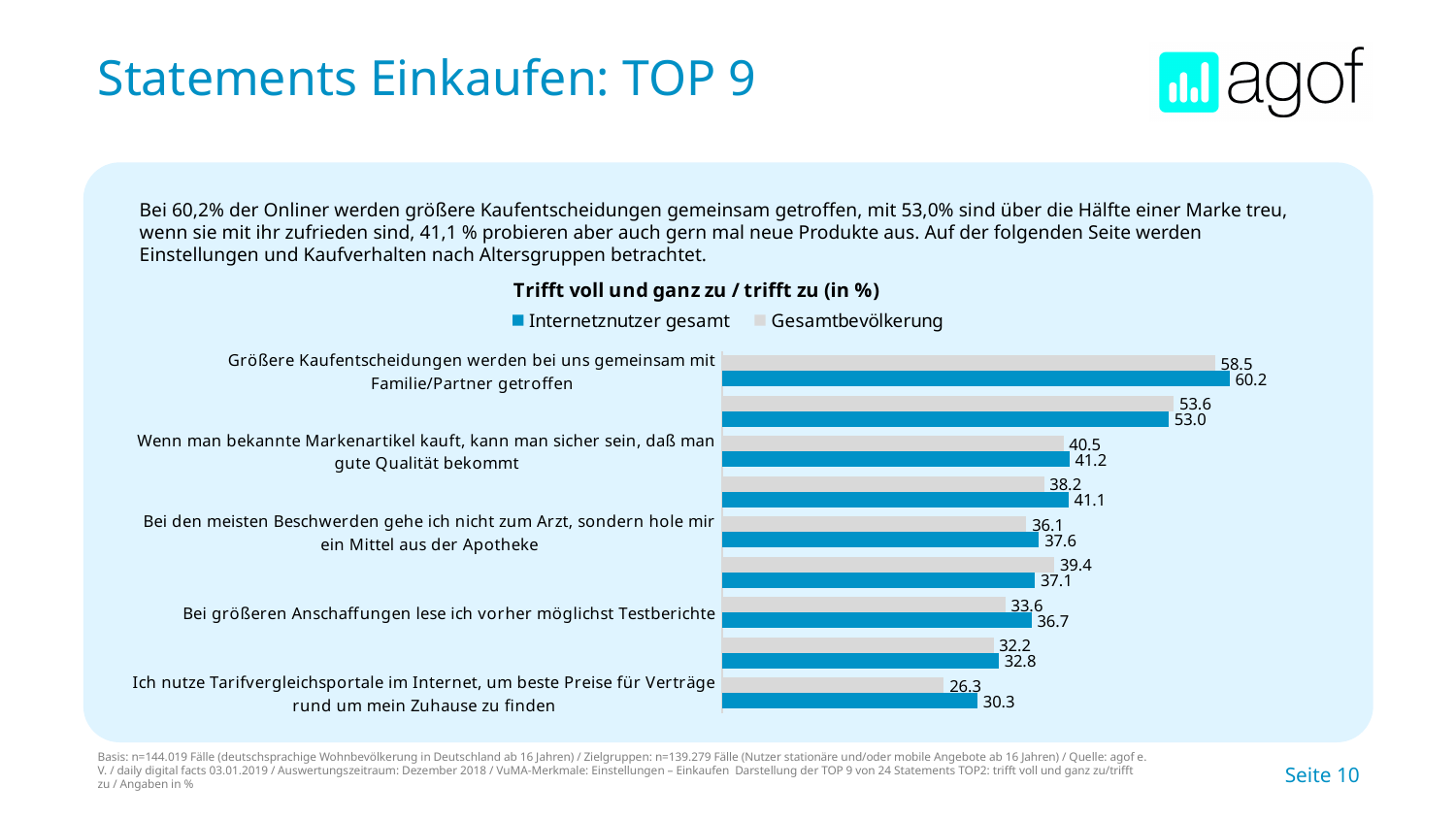
What is the value for Gesamtbevölkerung for the statement "Größere Kaufentscheidungen werden bei uns gemeinsam mit Familie/Partner getroffen"? 58.5 What kind of chart is shown on the slide? Bar chart What is the title of the chart? Trifft voll und ganz zu / trifft zu (in %) Which statement has the lowest value for Gesamtbevölkerung? Ich nutze Tarifvergleichsportale im Internet, um beste Preise für Verträge rund um mein Zuhause zu finden What is the difference between Internetnutzer gesamt and Gesamtbevölkerung for the statement "Bei größeren Anschaffungen lese ich vorher möglichst Testberichte"? 3.1 How many series does the legend list? 2 What is the value for Internetnutzer gesamt for the statement "Ich nutze Tarifvergleichsportale im Internet, um beste Preise für Verträge rund um mein Zuhause zu finden"? 30.3 For the statement "Ich nutze Tarifvergleichsportale im Internet, um beste Preise für Verträge rund um mein Zuhause zu finden", which series has the larger value, Internetnutzer gesamt or Gesamtbevölkerung? Internetnutzer gesamt What is the value for Internetnutzer gesamt for the statement "Größere Kaufentscheidungen werden bei uns gemeinsam mit Familie/Partner getroffen"? 60.2 What is the value for Gesamtbevölkerung for the statement "Bei den meisten Beschwerden gehe ich nicht zum Arzt, sondern hole mir ein Mittel aus der Apotheke"? 36.1 Which statement has the highest value for Internetnutzer gesamt? Größere Kaufentscheidungen werden bei uns gemeinsam mit Familie/Partner getroffen What is the value for Internetnutzer gesamt for the statement "Wenn man bekannte Markenartikel kauft, kann man sicher sein, daß man gute Qualität bekommt"? 41.2